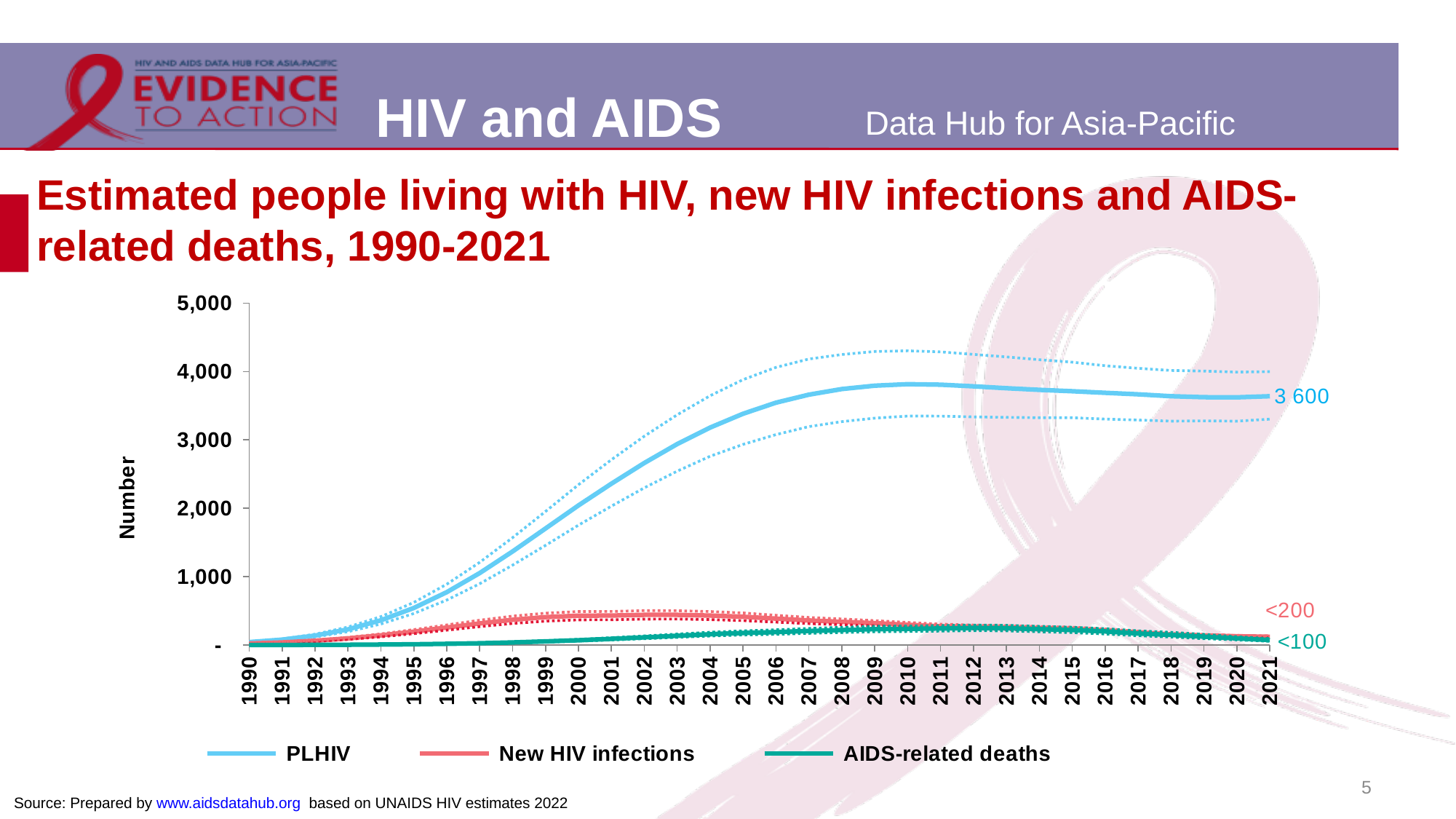
What kind of chart is shown on the slide? line chart How many years are shown along the x axis? 32 Is the value for PLHIV in 2010 greater or less than 3,000? greater What is the title of the y axis? Number Which series has the highest value in 2021? PLHIV What is the labelled value for New HIV infections in 2021? <200 Does the PLHIV line rise or fall between 1990 and 2010? rise What is the labelled value for PLHIV in 2021? 3 600 Is the value for PLHIV in 1995 greater or less than 1,000? less Which series has the lowest value in 2021? AIDS-related deaths How many series does the legend list? 3 What is the labelled value for AIDS-related deaths in 2021? <100